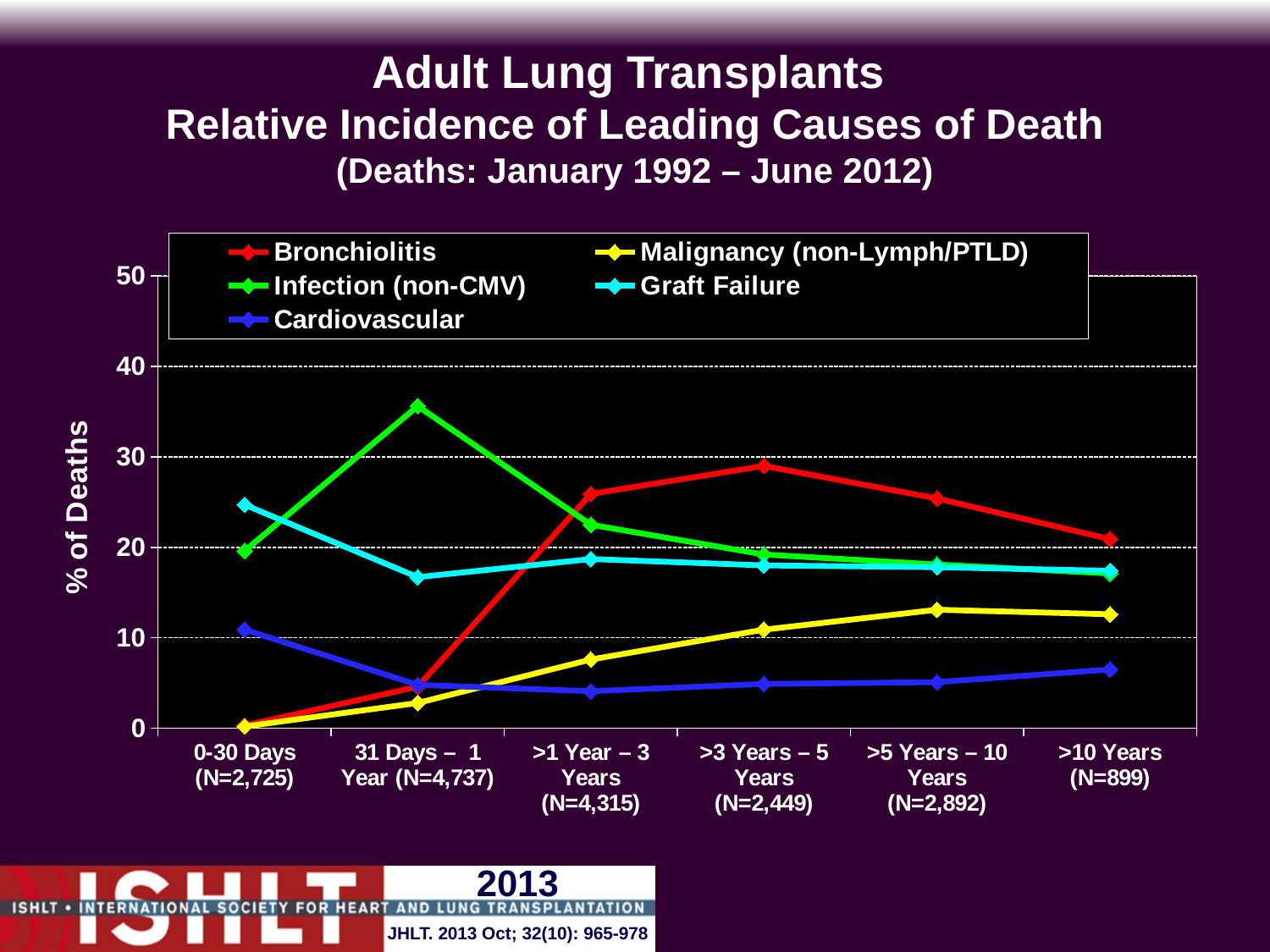
What is the y-axis title of the chart? % of Deaths How many time-period categories are shown on the x axis? 6 Which cause of death has the lowest % of Deaths in the >10 Years period? Cardiovascular What kind of chart is shown on the slide? line chart How many series does the legend list? 5 Is the value for Malignancy (non-Lymph/PTLD) in the >5 Years – 10 Years period greater or less than 10? greater Which cause of death has the highest % of Deaths in the >3 Years – 5 Years period? Bronchiolitis In the 0-30 Days period, which is larger: Graft Failure or Infection (non-CMV)? Graft Failure Does the Bronchiolitis line rise or fall from 0-30 Days to >3 Years – 5 Years? rise Is the value for Infection (non-CMV) in the 31 Days – 1 Year period greater or less than 30? greater Which cause of death has the highest % of Deaths in the 31 Days – 1 Year period? Infection (non-CMV)